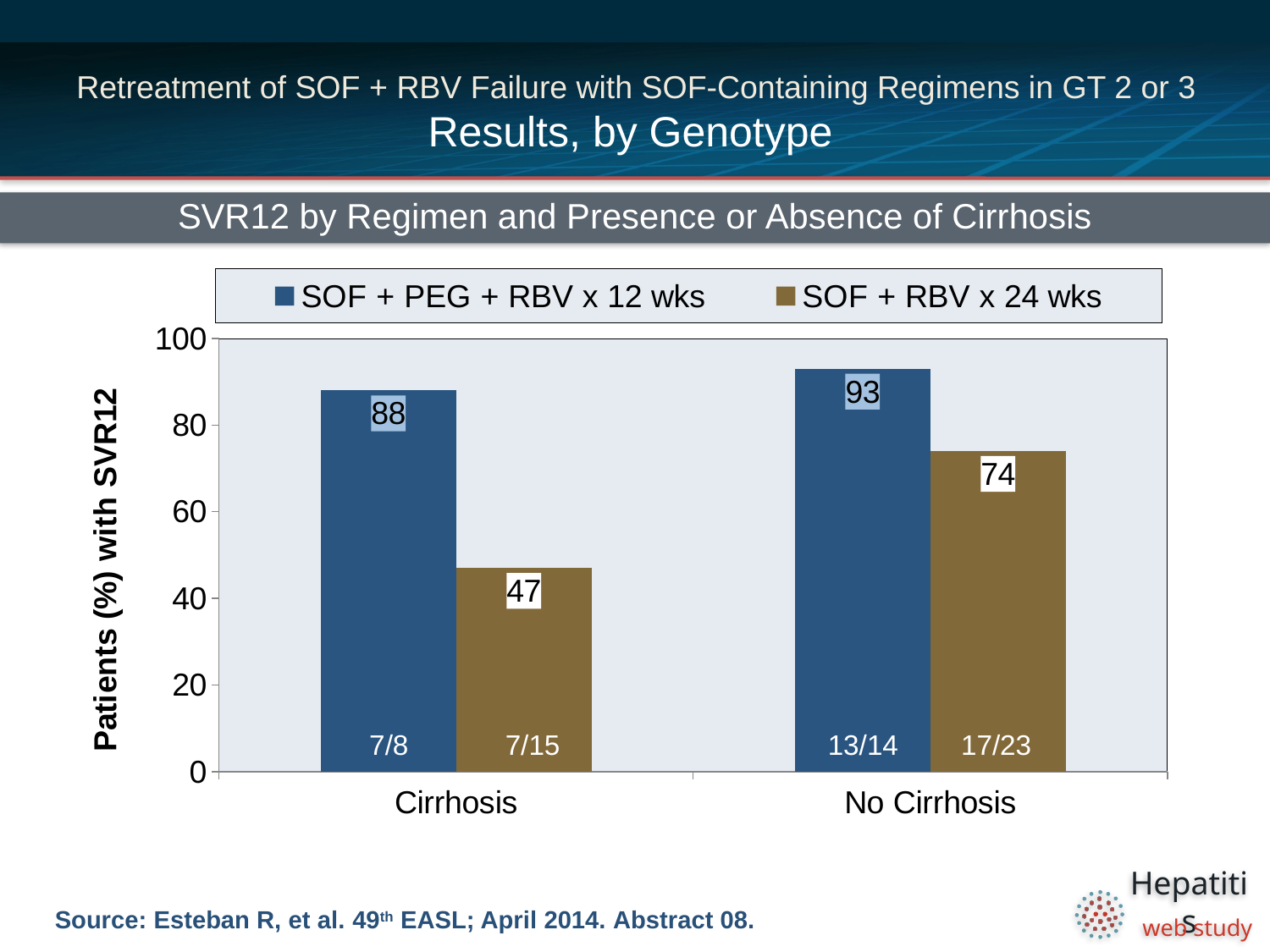
What is the SVR12 value for SOF + PEG + RBV x 12 wks in the Cirrhosis group? 88 What kind of chart is shown on the slide? Bar chart What is the difference between the SVR12 values of the two regimens in the No Cirrhosis group? 19 How many categories are shown on the x axis? 2 Which bar has the highest SVR12 value? SOF + PEG + RBV x 12 wks, No Cirrhosis What is the difference between the SVR12 values of the two regimens in the Cirrhosis group? 41 What is the SVR12 value for SOF + RBV x 24 wks in the No Cirrhosis group? 74 How many series does the legend list? 2 Which bar has the lowest SVR12 value? SOF + RBV x 24 wks, Cirrhosis Which regimen has the higher SVR12 in the No Cirrhosis group? SOF + PEG + RBV x 12 wks What fraction of patients is shown for SOF + PEG + RBV x 12 wks in the No Cirrhosis group? 13/14 What is the SVR12 value for SOF + RBV x 24 wks in the Cirrhosis group? 47